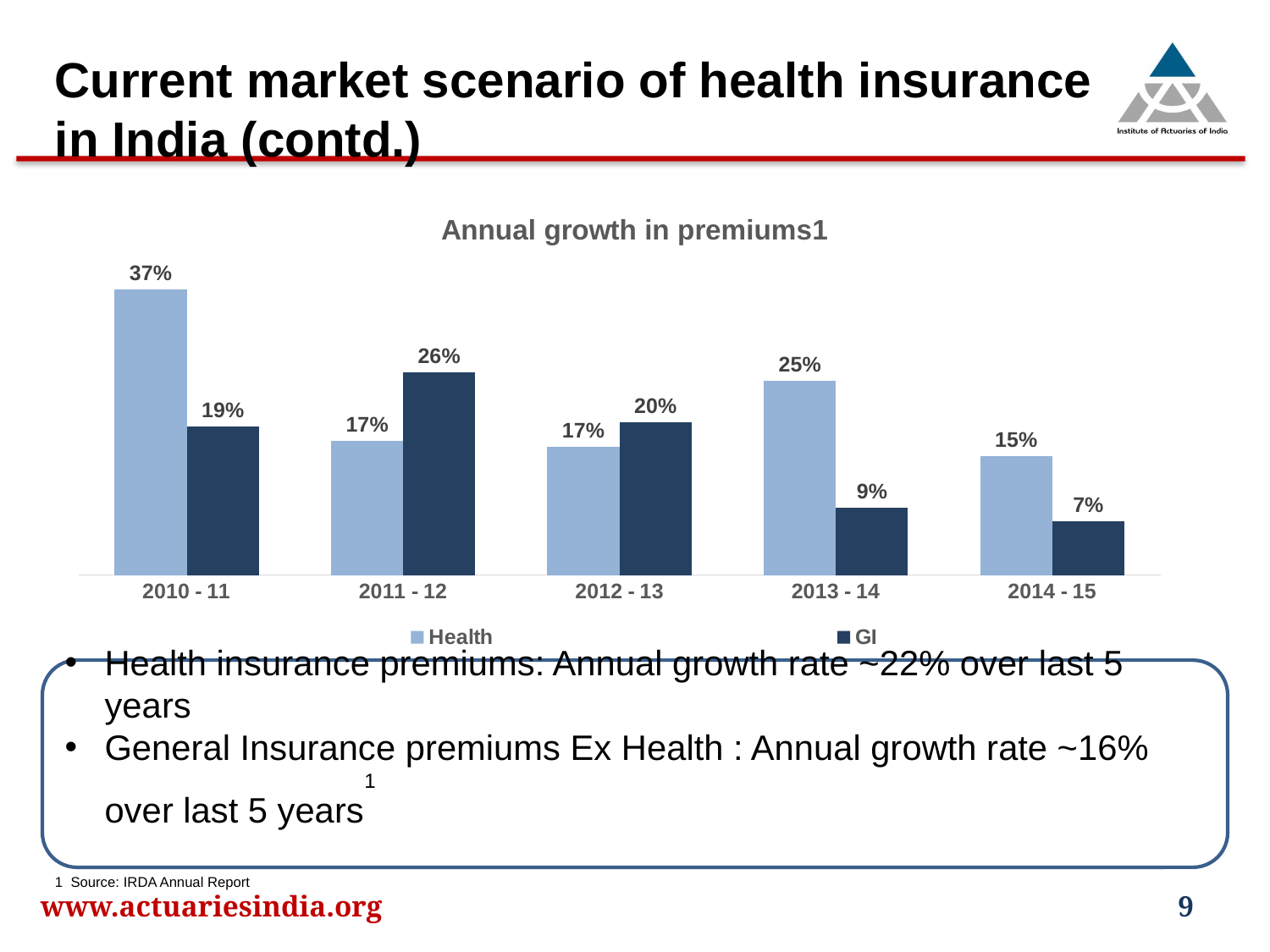
What is the GI growth value for 2011 - 12? 26% Which year has the lowest GI growth value? 2014 - 15 Does the GI growth value rise or fall from 2011 - 12 to 2014 - 15? Fall Which year has the highest Health growth value? 2010 - 11 How many series does the legend list? 2 What is the difference between the Health and GI values for 2013 - 14? 16% What is the title of the chart? Annual growth in premiums1 What is the GI growth value for 2014 - 15? 7% Which is larger in 2012 - 13, the Health value or the GI value? GI What kind of chart is shown on the slide? Bar chart What is the Health growth value for 2010 - 11? 37% How many years are shown on the x axis? 5